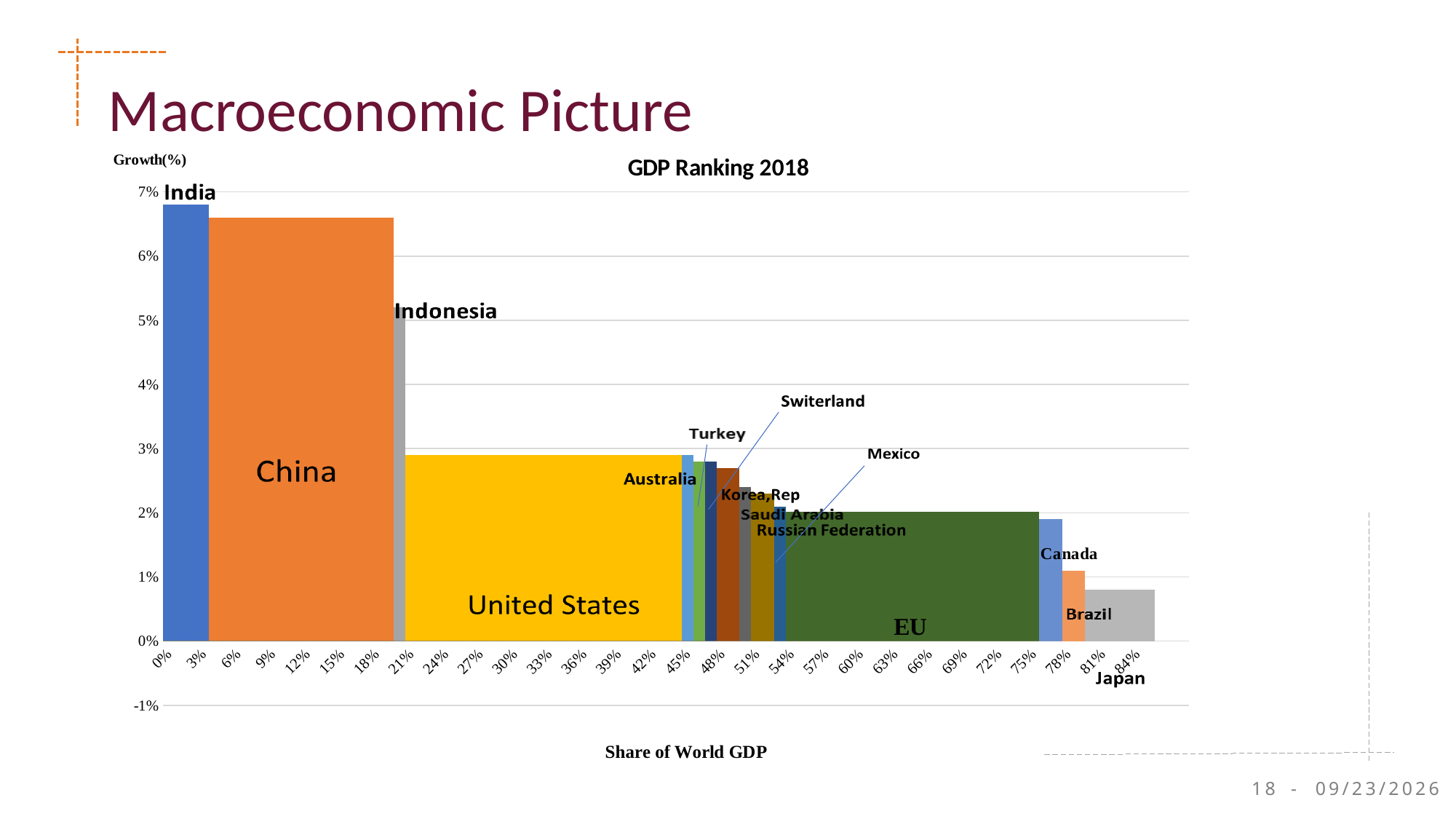
Is the growth value for Japan greater or less than 1%? less Is the growth value for China greater or less than 6%? greater Which has a higher growth value, China or United States? China What is the title of the chart? GDP Ranking 2018 What type of chart is shown on the slide? Bar chart What is the label of the horizontal axis? Share of World GDP Which bar is wider along the Share of World GDP axis, China or United States? United States Is the growth value for Indonesia greater or less than 5%? greater Which country has the lowest growth value in the chart? Japan Which has a higher growth value, Indonesia or Brazil? Indonesia How many countries or regions are labelled in the chart? 15